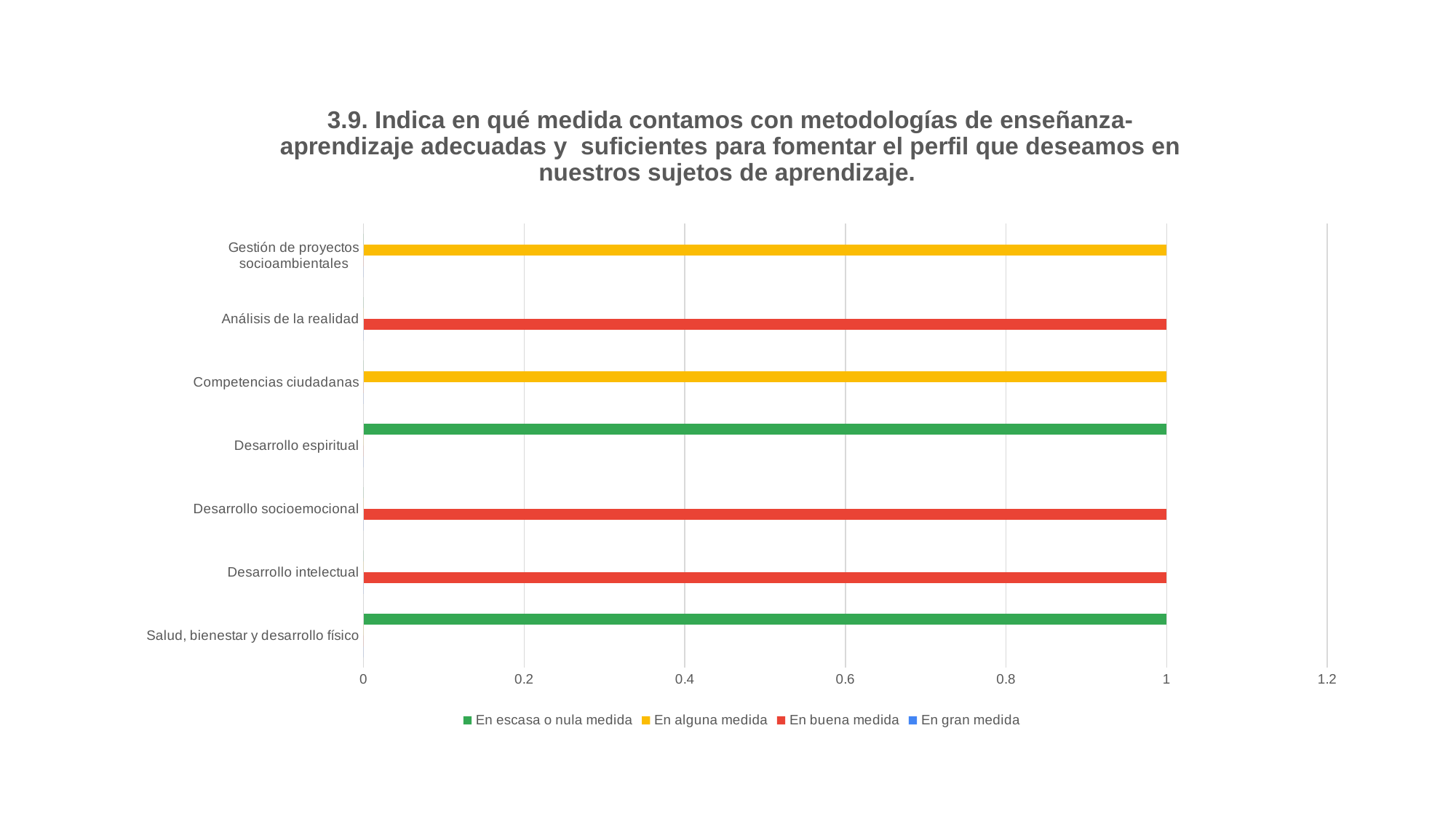
What kind of chart is shown on the slide? Bar chart How many categories have a bar in the 'En buena medida' series? 3 What is the value of the 'En buena medida' bar for 'Desarrollo intelectual'? 1 What is the value of the 'En alguna medida' bar for 'Gestión de proyectos socioambientales'? 1 What is the value of the 'En escasa o nula medida' bar for 'Desarrollo espiritual'? 1 How many categories are listed on the vertical axis of the chart? 7 What is the value of the 'En buena medida' bar for 'Análisis de la realidad'? 1 Is the value for 'Salud, bienestar y desarrollo físico' greater or less than 0.8? greater How many series does the chart's legend list? 4 Which series does the bar for 'Competencias ciudadanas' belong to? En alguna medida Which series does the bar for 'Desarrollo socioemocional' belong to? En buena medida Is the value for 'Competencias ciudadanas' greater or less than 1.2? less